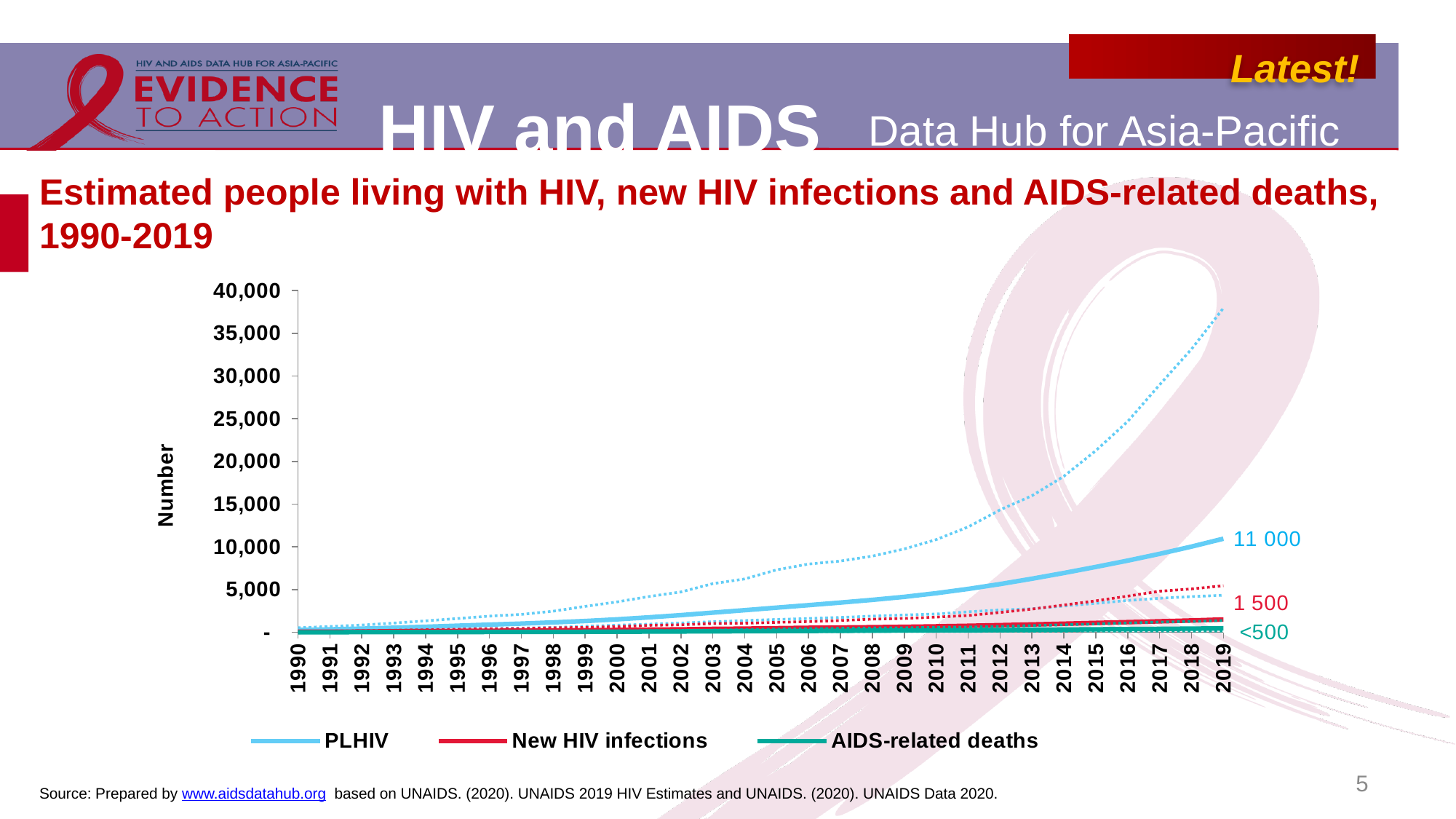
How many years are shown along the x axis? 30 Which series has the lowest value in 2019? AIDS-related deaths What is the difference between the PLHIV value and the new HIV infections value in 2019? 9 500 How many series does the legend list? 3 What is the estimated number of new HIV infections in 2019? 1 500 What is the label on the y axis? Number What kind of chart is shown on the slide? Line chart What is the estimated number of AIDS-related deaths in 2019? <500 Which series has the highest value in 2019? PLHIV What is the estimated number of people living with HIV (PLHIV) in 2019? 11 000 Does the PLHIV line rise or fall from 1990 to 2019? Rise